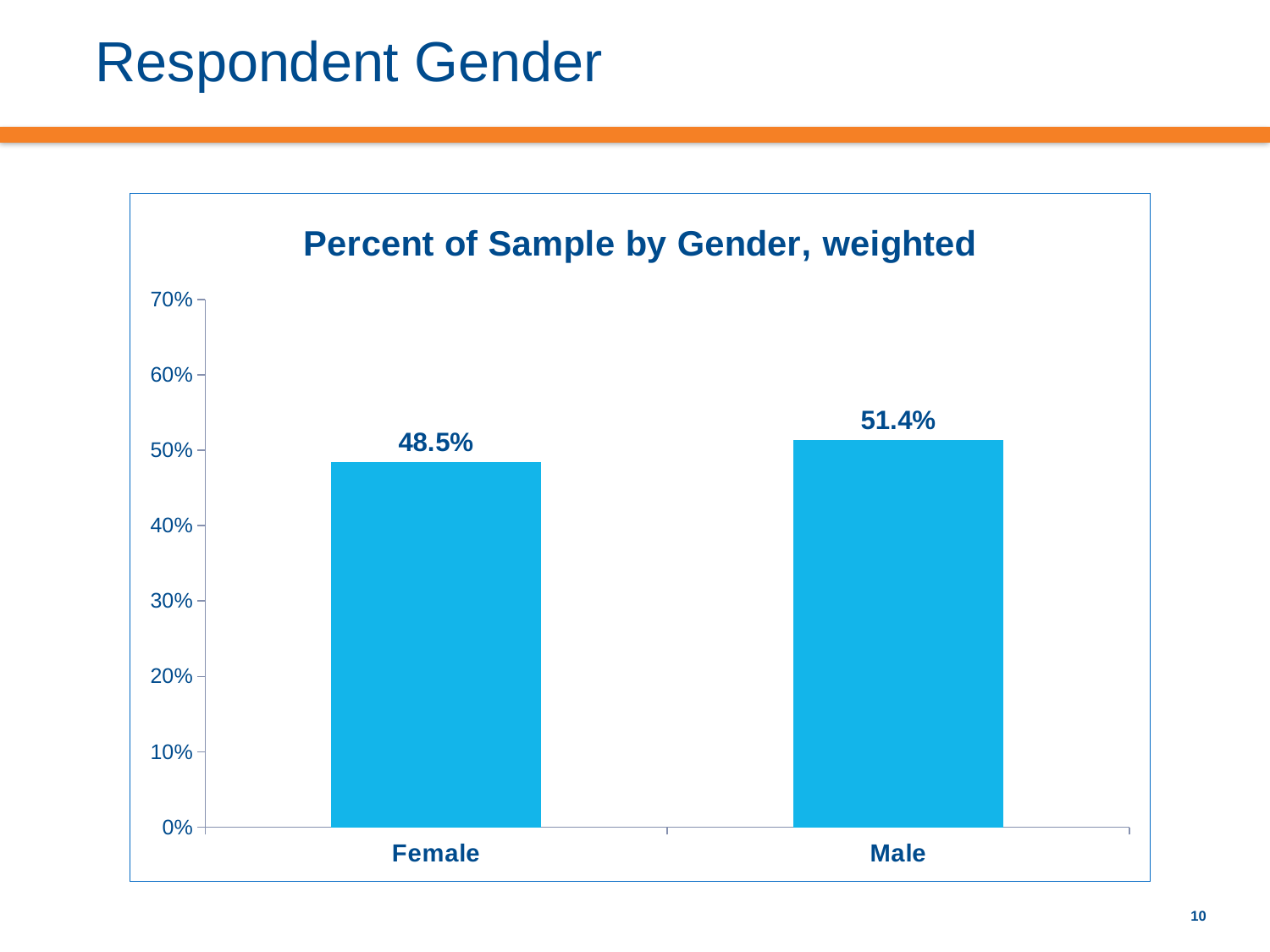
Which is larger, the value for Female or the value for Male? Male What is the difference between the values for Male and Female? 2.9% What is the title of the chart? Percent of Sample by Gender, weighted Is the value for Female greater or less than 50%? less What is the highest value shown on the y axis? 70% Which category has the lowest value? Female What is the value for Female? 48.5% What is the value for Male? 51.4% What kind of chart is shown on the slide? bar chart How many categories are shown on the x axis? 2 Which category has the highest value? Male Is the value for Male greater or less than 50%? greater